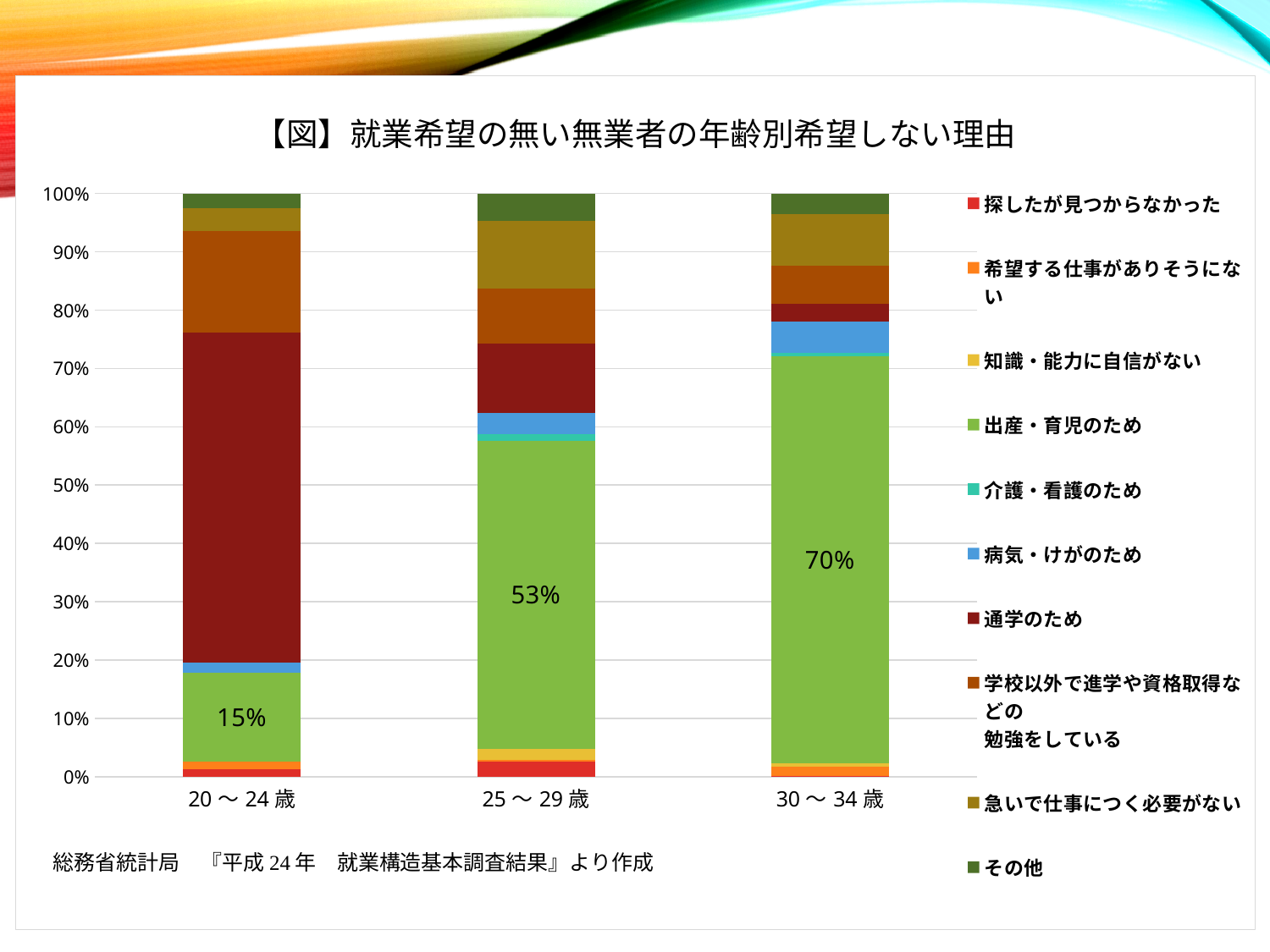
What is the difference between the 出産・育児のため share for 30～34歳 and for 20～24歳? 55 percentage points What kind of chart is shown on the slide? Stacked bar chart What is the value for 出産・育児のため in the 20～24歳 bar? 15% How many series does the legend list? 10 Which age group has the highest share for 出産・育児のため? 30～34歳 How many age groups are shown on the x axis? 3 Which is larger, the 出産・育児のため share for 25～29歳 or for 30～34歳? 30～34歳 What is the value for 出産・育児のため in the 25～29歳 bar? 53% Is the 通学のため segment in the 20～24歳 bar greater or less than 50%? greater What is the value for 出産・育児のため in the 30～34歳 bar? 70% Does the share for 出産・育児のため rise or fall as the age group increases? Rises Which age group has the lowest share for 出産・育児のため? 20～24歳